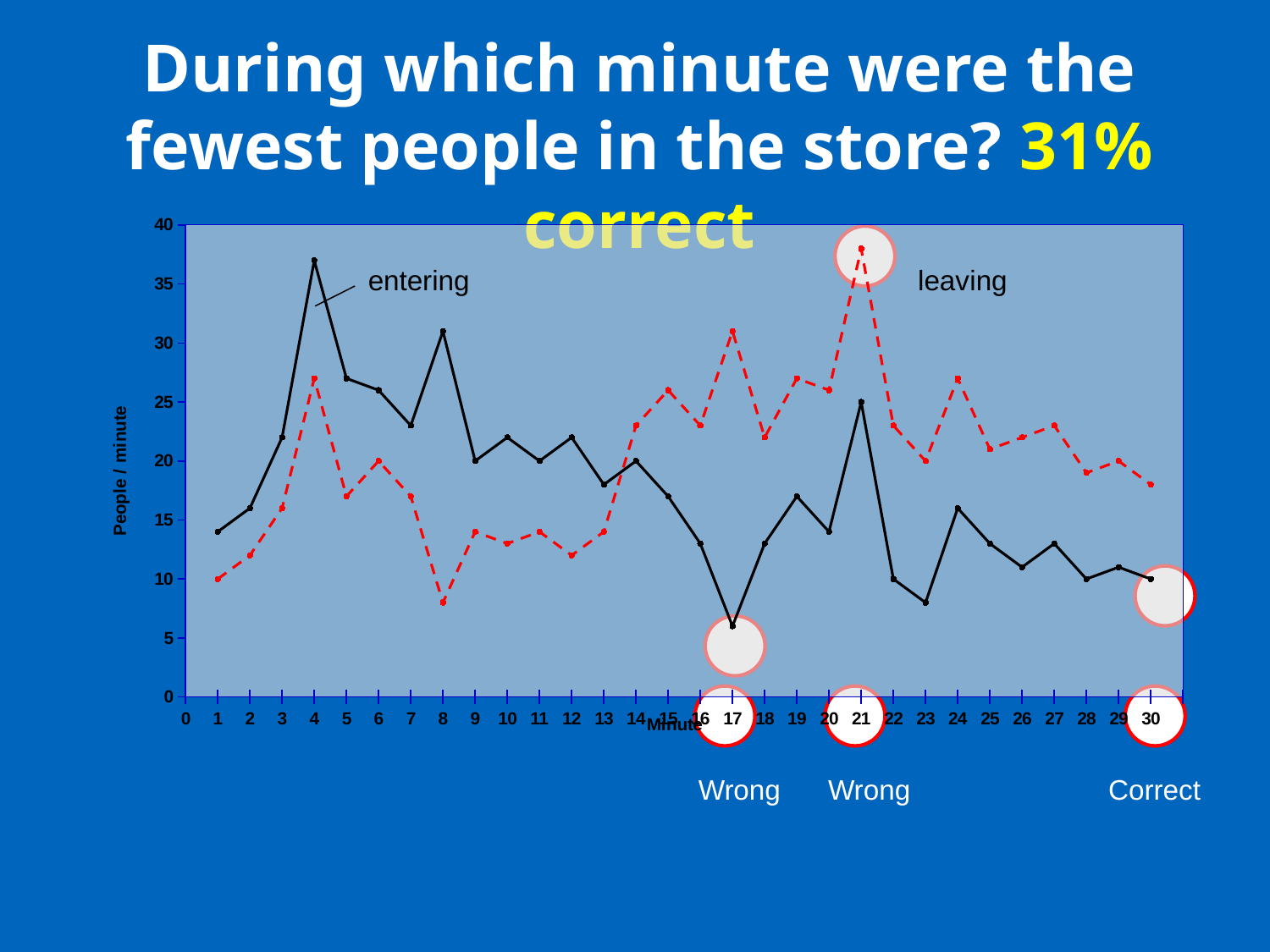
How many series does the chart show? 2 What is the label on the vertical axis of the chart? People / minute At which minute does the leaving series reach its highest value? 21 What kind of chart is shown on the slide? line chart At which minute does the entering series reach its lowest value? 17 Is the entering value at minute 4 greater or less than 35? greater Is the leaving value at minute 30 greater or less than 20? less At minute 4, which series has the larger value, entering or leaving? entering At which minute does the entering series reach its highest value? 4 At minute 21, which series has the larger value, entering or leaving? leaving Is the entering value at minute 17 greater or less than 10? less At which minute does the leaving series reach its lowest value? 8